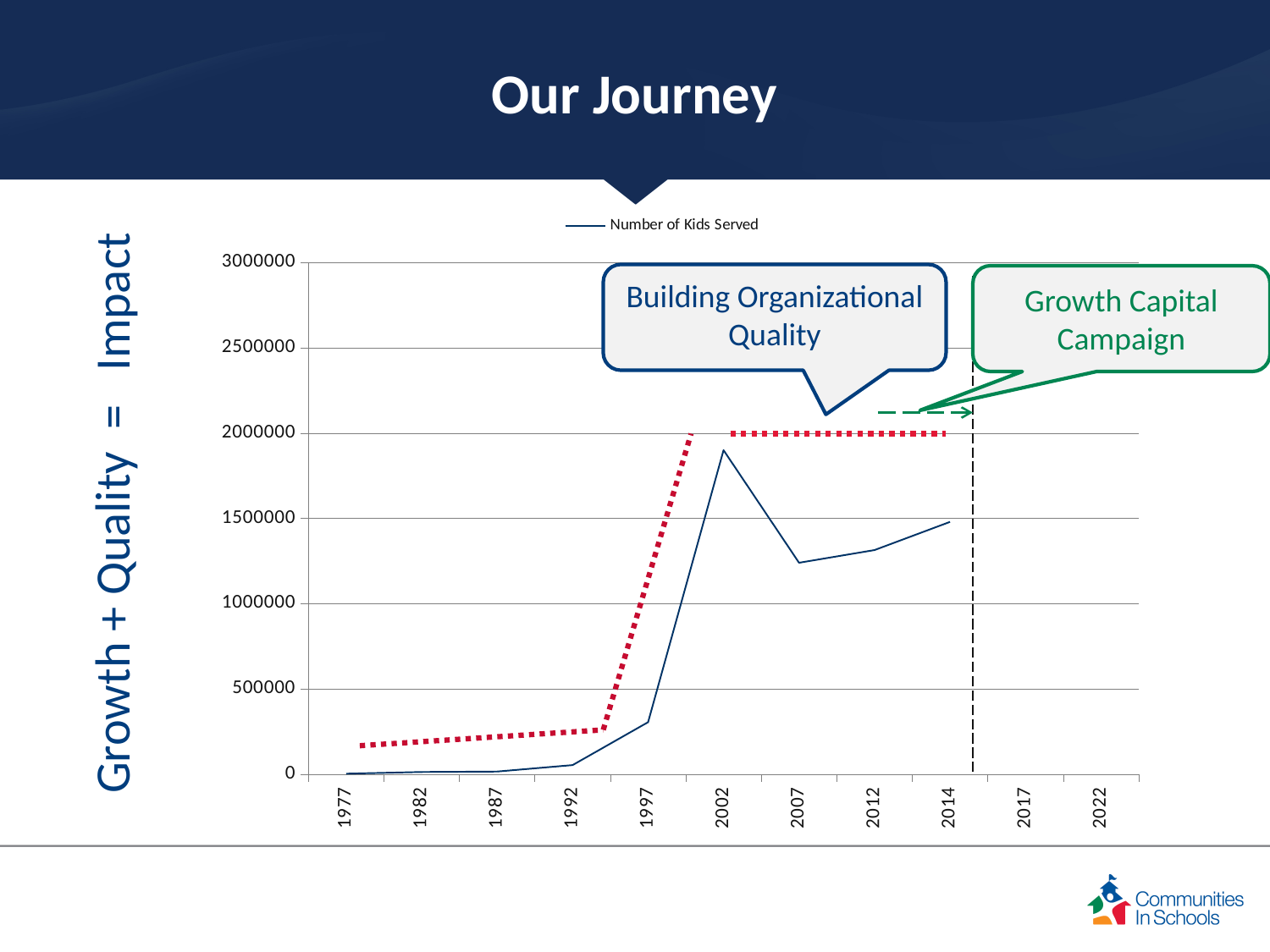
Is the Number of Kids Served in 2007 greater or less than 1500000? less What kind of chart is shown on the slide? line chart Is the Number of Kids Served in 2002 greater or less than 1500000? greater Is the Number of Kids Served in 2014 greater or less than 1000000? greater Does the Number of Kids Served rise or fall between 2007 and 2014? rise In which year does the Number of Kids Served reach its highest point? 2002 What is the name of the series shown in the chart legend? Number of Kids Served How many series does the chart legend list? 1 In which year is the Number of Kids Served lowest? 1977 How many year labels are shown on the x axis? 11 Which year has a higher Number of Kids Served, 2002 or 2014? 2002